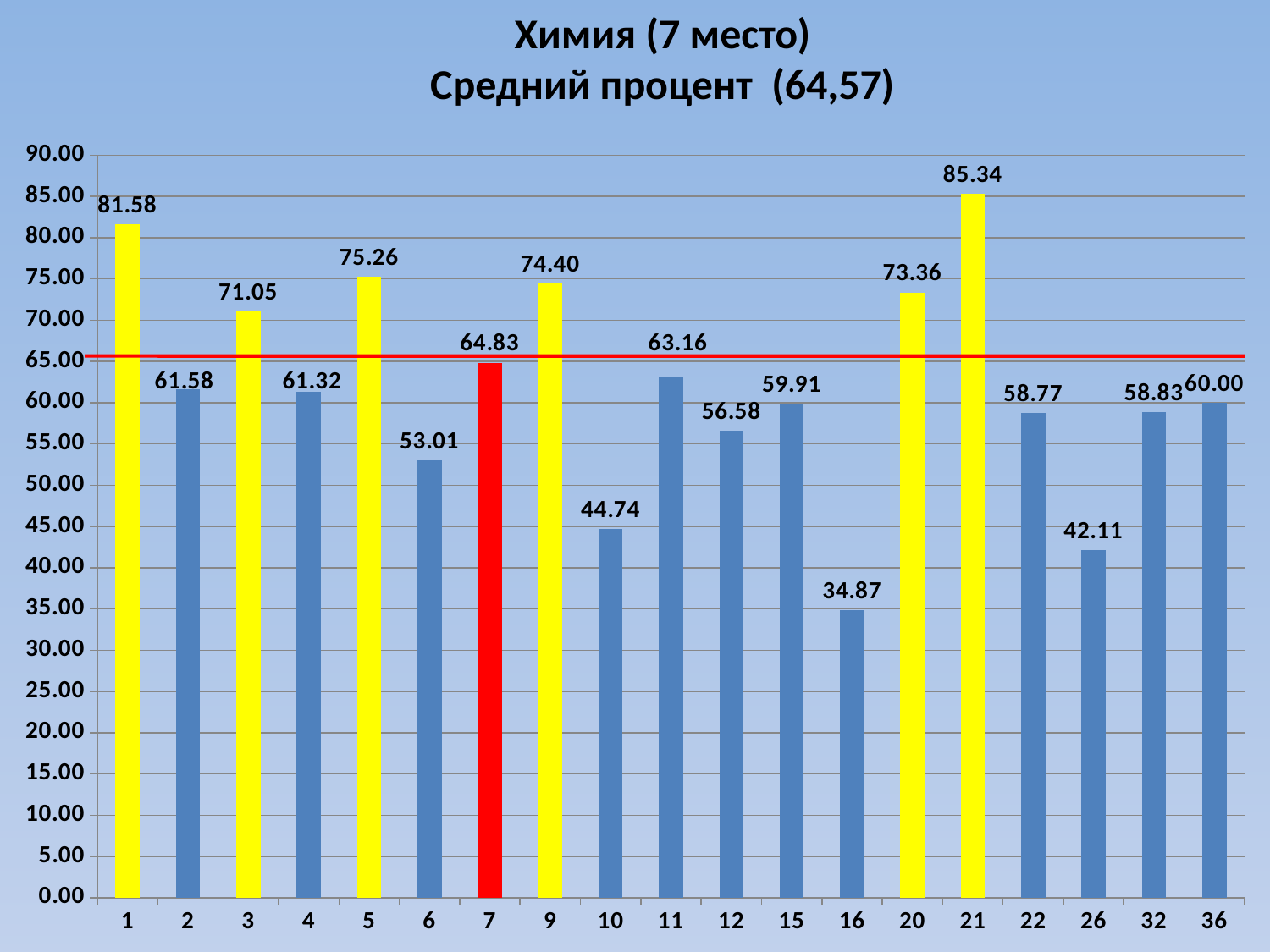
What kind of chart is shown on the slide? bar chart What is the value for category 7? 64.83 What is the value for category 21? 85.34 What is the difference between the values for category 21 and category 1? 3.76 Which is larger, the value for category 10 or the value for category 26? 10 Which category has the lowest value? 16 How many bars are shown in the chart? 19 What is the value for category 16? 34.87 What colour is the bar for category 7? red What is the difference between the values for category 7 and category 16? 29.96 What is the value for category 36? 60.00 Which category has the highest value? 21